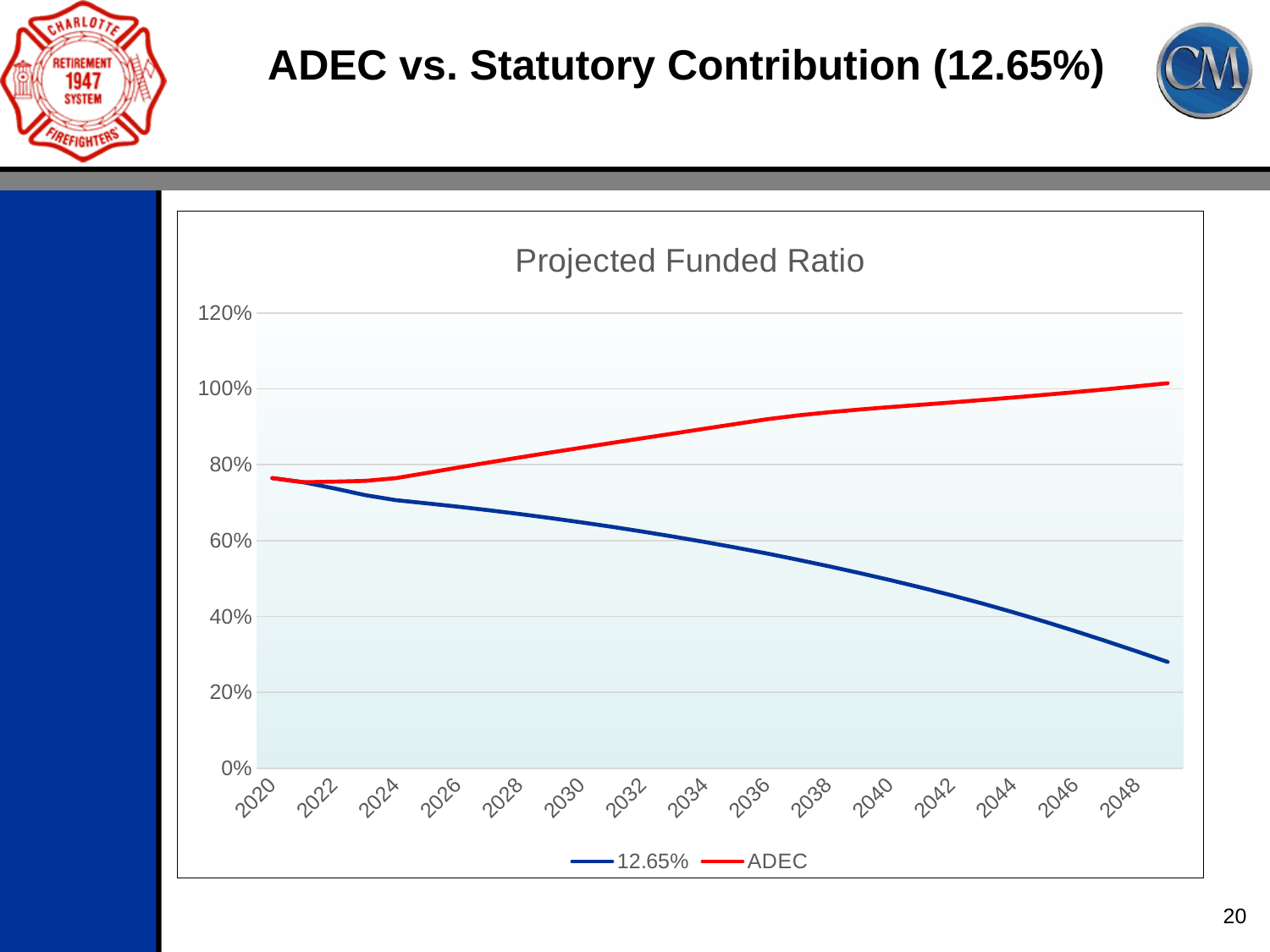
Which two series are listed in the legend? 12.65% and ADEC What is the title of the chart? Projected Funded Ratio Which series has the lower funded ratio in 2040? 12.65% How many year labels are shown on the x axis? 15 How many series does the legend list? 2 Does the 12.65% series rise or fall from 2020 to 2048? fall Is the value for the 12.65% series in 2048 greater or less than 40%? less What kind of chart is shown on the slide? line chart Which series has the higher funded ratio in 2048? ADEC Does the ADEC series rise or fall from 2020 to 2048? rise Is the value for the ADEC series in 2040 greater or less than 100%? less Is the value for the ADEC series in 2030 greater or less than 80%? greater